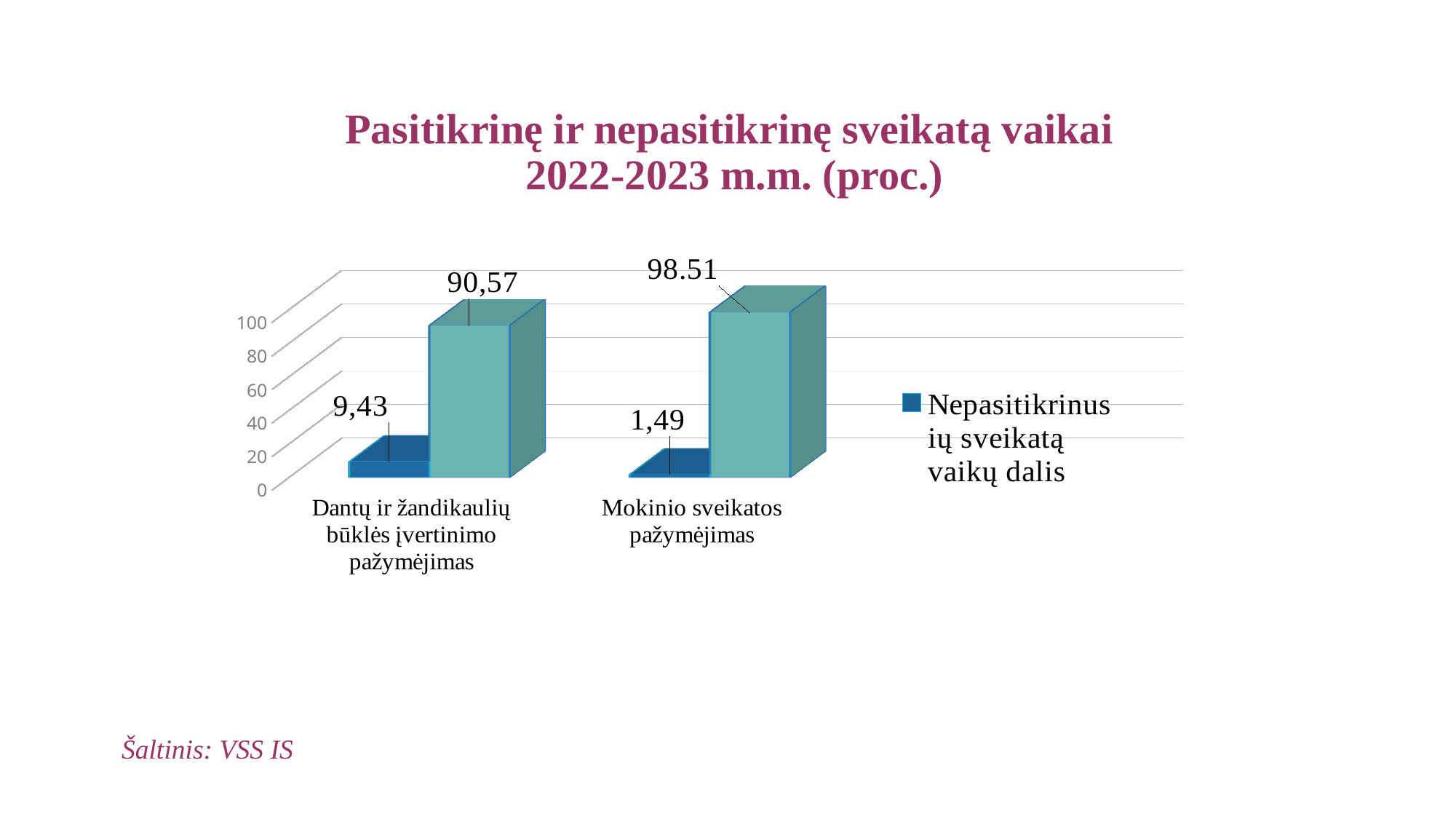
What is the value of the teal bar for 'Dantų ir žandikaulių būklės įvertinimo pažymėjimas'? 90,57 Is the teal bar for 'Mokinio sveikatos pažymėjimas' greater or less than 80? greater What is the value of the dark blue bar (Nepasitikrinusių sveikatą vaikų dalis) for 'Dantų ir žandikaulių būklės įvertinimo pažymėjimas'? 9,43 What is the difference between the dark blue values for 'Dantų ir žandikaulių būklės įvertinimo pažymėjimas' and 'Mokinio sveikatos pažymėjimas'? 7,94 What is the value of the dark blue bar (Nepasitikrinusių sveikatą vaikų dalis) for 'Mokinio sveikatos pažymėjimas'? 1,49 Which category has the higher value for the dark blue series (Nepasitikrinusių sveikatą vaikų dalis)? Dantų ir žandikaulių būklės įvertinimo pažymėjimas What is the difference between the teal bar and the dark blue bar for 'Dantų ir žandikaulių būklės įvertinimo pažymėjimas'? 81,14 How many categories are shown on the x axis? 2 What kind of chart is shown on the slide? Bar chart Which category has the lower value for the teal series? Dantų ir žandikaulių būklės įvertinimo pažymėjimas How many series does the legend list? 1 What is the value of the teal bar for 'Mokinio sveikatos pažymėjimas'? 98.51